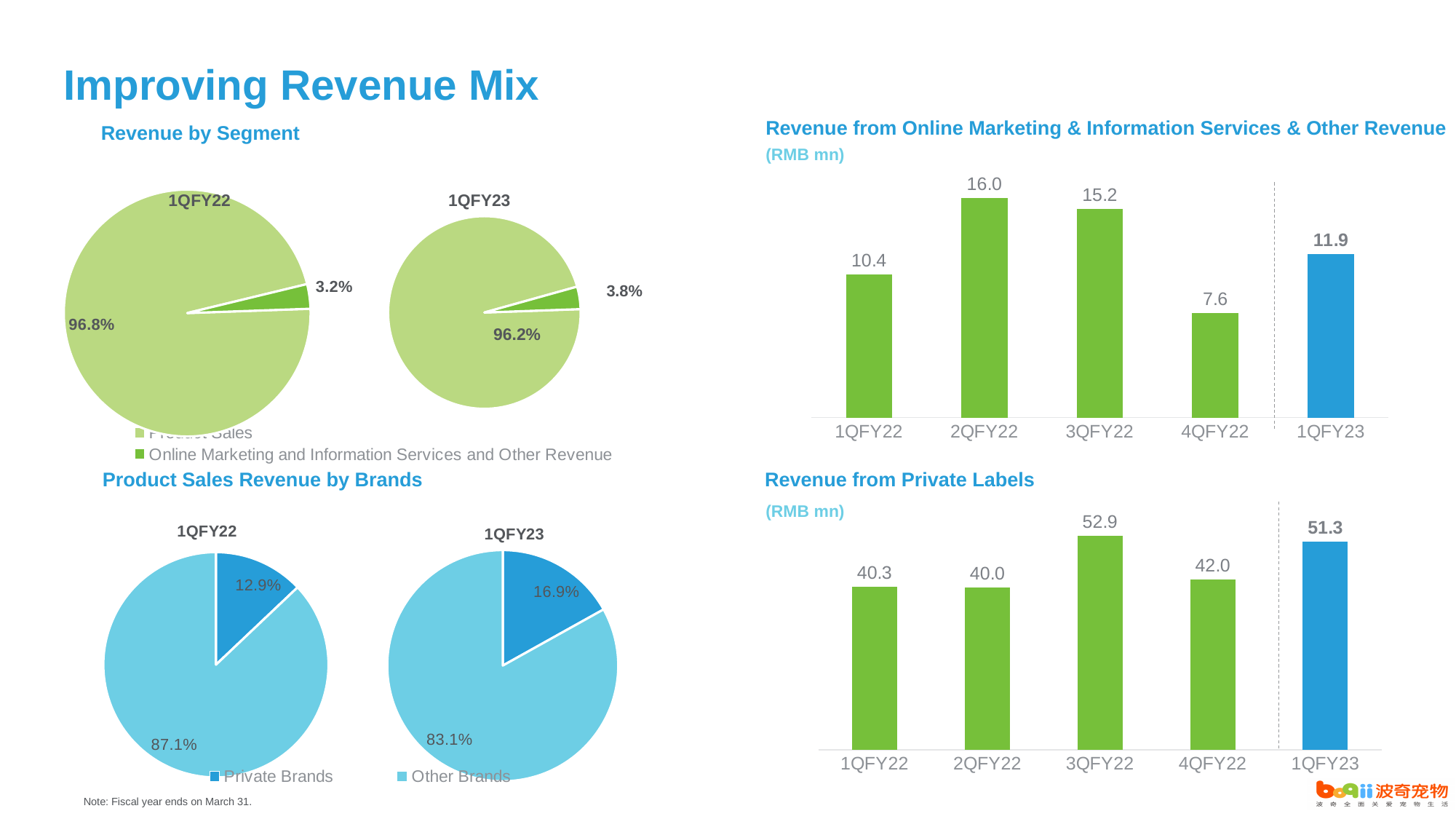
In the 'Product Sales Revenue by Brands' 1QFY23 pie chart, what share is Private Brands? 16.9% In the 'Revenue from Private Labels' chart, how many quarters are shown? 5 How many series does the legend of the 'Product Sales Revenue by Brands' charts list? 2 In the 'Revenue by Segment' 1QFY22 pie chart, what share is Product Sales? 96.8% In the 'Revenue from Online Marketing & Information Services & Other Revenue' chart, what is the difference between 1QFY23 and 1QFY22? 1.5 In the 'Revenue from Private Labels' chart, is the value for 4QFY22 larger or smaller than the value for 1QFY23? smaller In the 'Revenue from Private Labels' chart, which quarter has the highest value? 3QFY22 In the 'Revenue from Private Labels' chart, what is the value for 1QFY23? 51.3 What kind of chart is 'Revenue from Private Labels'? bar chart In the 'Revenue from Online Marketing & Information Services & Other Revenue' chart, what is the value for 2QFY22? 16.0 In the 'Revenue by Segment' 1QFY23 pie chart, what share is Online Marketing and Information Services and Other Revenue? 3.8% In the 'Revenue from Online Marketing & Information Services & Other Revenue' chart, which quarter has the lowest value? 4QFY22